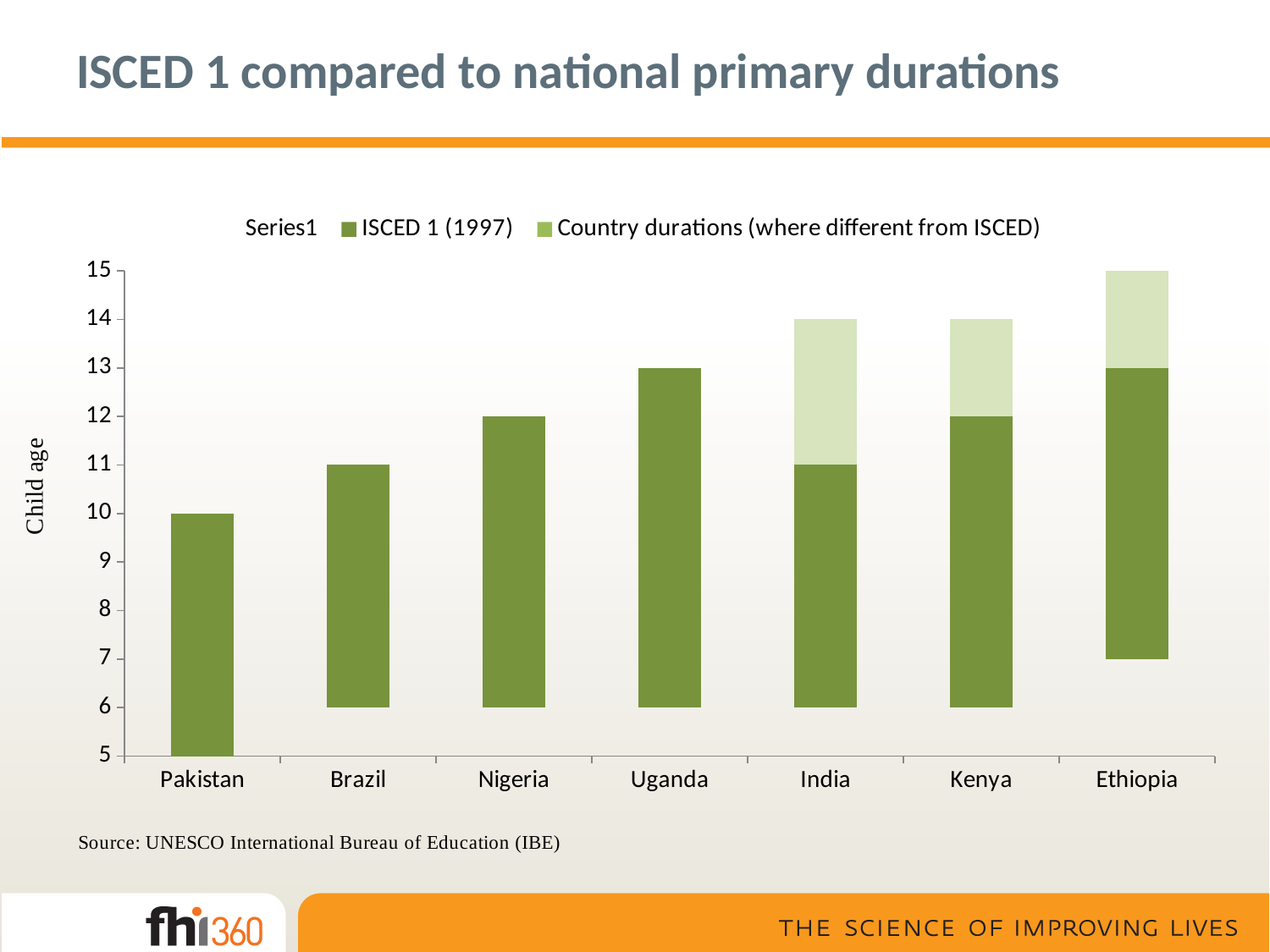
Is the top of the bar for Uganda greater or less than 12? greater What is the label on the y axis of the chart? Child age How many entries does the chart's legend list? 3 At what child age does the ISCED 1 (1997) segment for India end? 11 Which country's bar reaches the lowest child age? Pakistan What kind of chart is shown on the slide? bar chart At what child age does the Country durations segment for Ethiopia end? 15 How many countries are shown on the x axis of the chart? 7 Which bar reaches a higher child age, Nigeria or Brazil? Nigeria At what child age does the bar for Pakistan start? 5 Which country's bar reaches the highest child age? Ethiopia At what child age does the ISCED 1 (1997) bar for Uganda end? 13